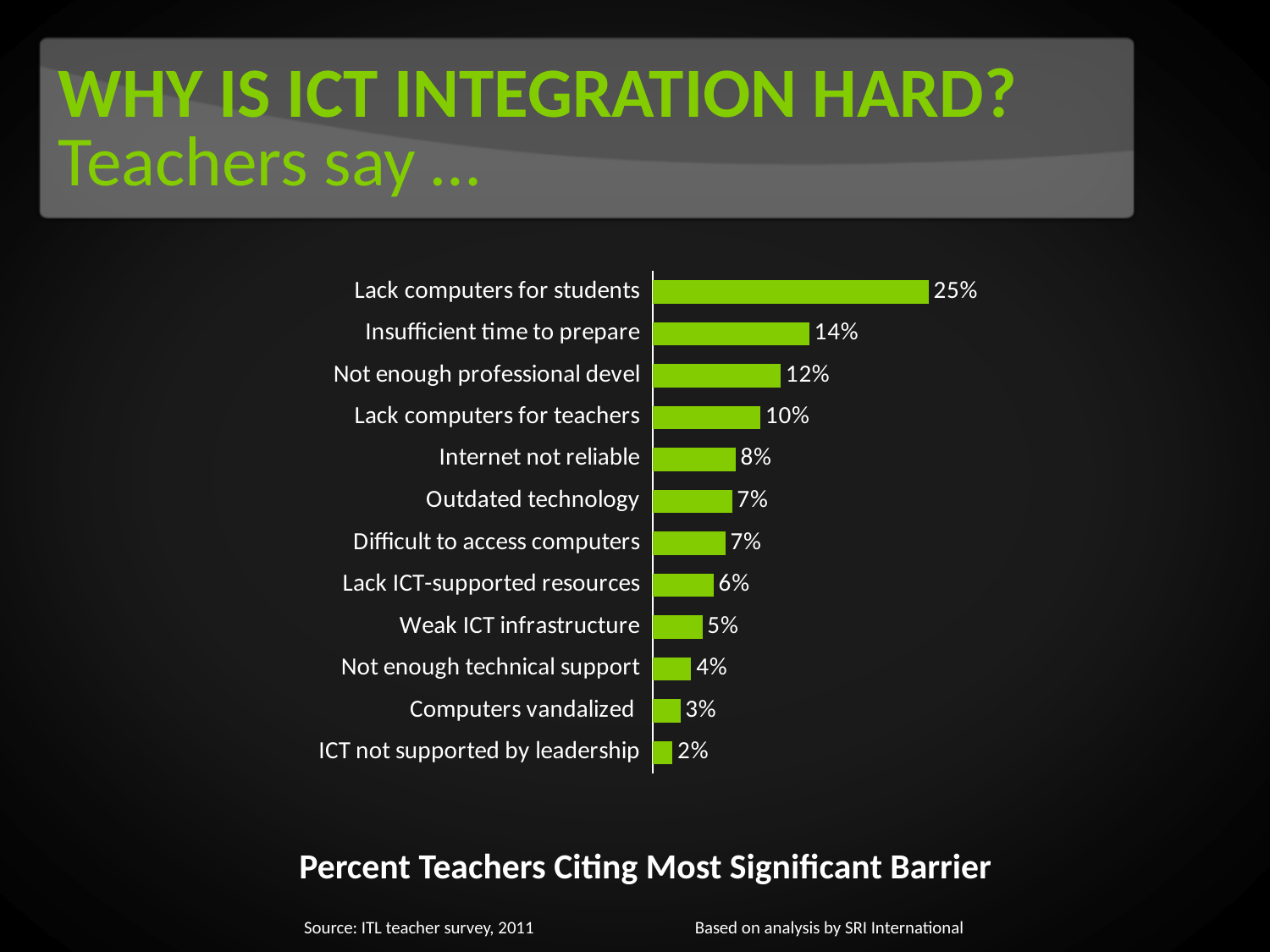
What is the difference between the values for 'Internet not reliable' and 'Computers vandalized'? 5% Which is larger: the value for 'Not enough professional devel' or the value for 'Lack computers for teachers'? Not enough professional devel What value is shown for 'Weak ICT infrastructure'? 5% What is the difference between the values for 'Lack computers for students' and 'Insufficient time to prepare'? 11% What colour are the bars in the chart? Green What kind of chart is shown on the slide? Bar chart What percent of teachers cited 'Lack computers for students' as the most significant barrier? 25% What is the title shown below the chart? Percent Teachers Citing Most Significant Barrier How many barriers (categories) are shown in the chart? 12 Which barrier has the lowest percentage of teachers citing it? ICT not supported by leadership Which barrier has the highest percentage of teachers citing it? Lack computers for students What value is shown for 'Insufficient time to prepare'? 14%